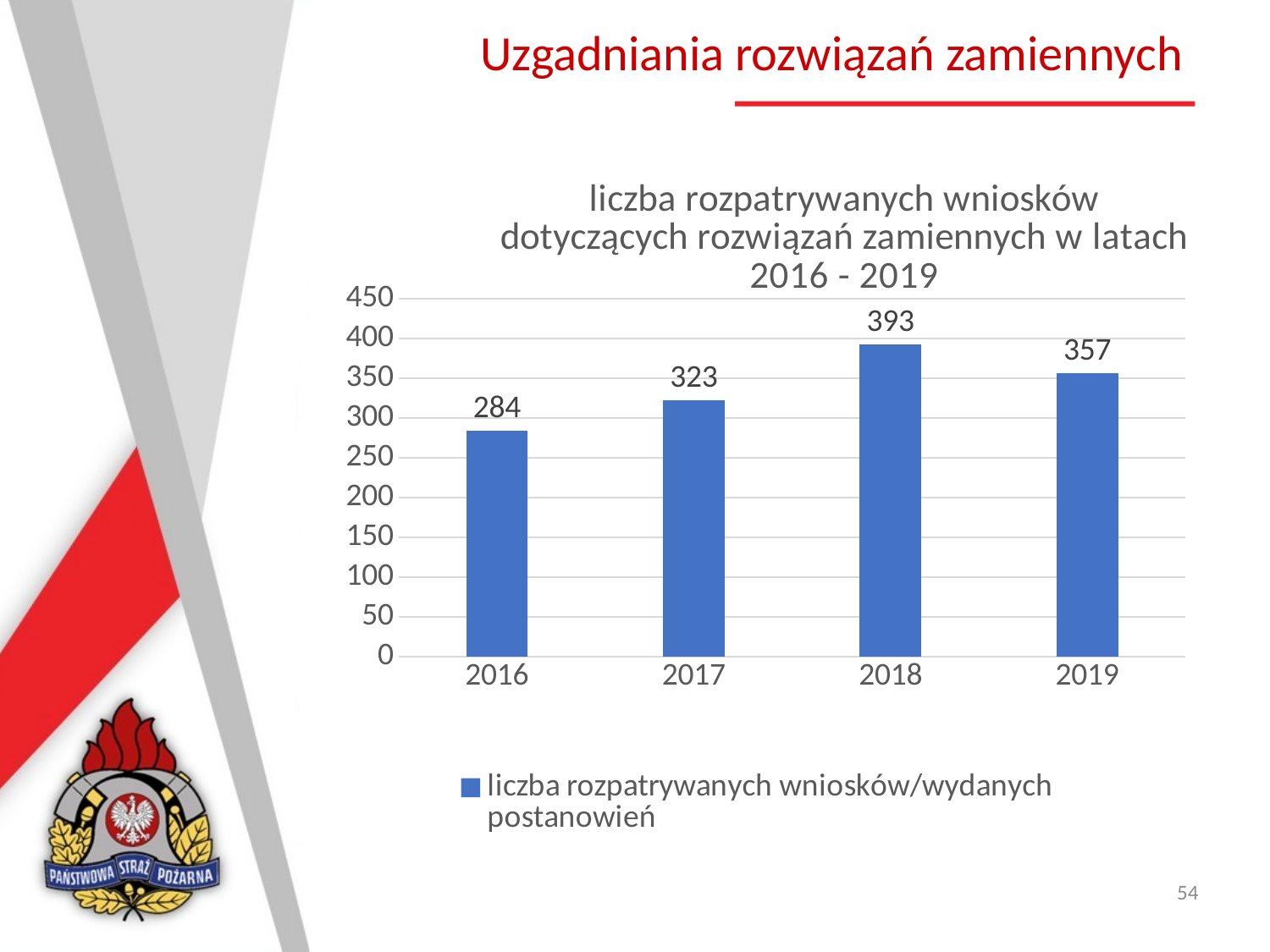
What is the difference between the values for 2018 and 2017? 70 Which is larger, the value for 2017 or the value for 2019? 2019 What is the value for 2016? 284 What is the legend entry for the series shown? liczba rozpatrywanych wniosków/wydanych postanowień What kind of chart is shown on the slide? bar chart What is the value for 2019? 357 How many years are shown on the x axis? 4 Is the value for 2017 greater or less than 300? greater Which year has the highest value? 2018 What is the value for 2018? 393 Which year has the lowest value? 2016 What is the difference between the values for 2019 and 2016? 73